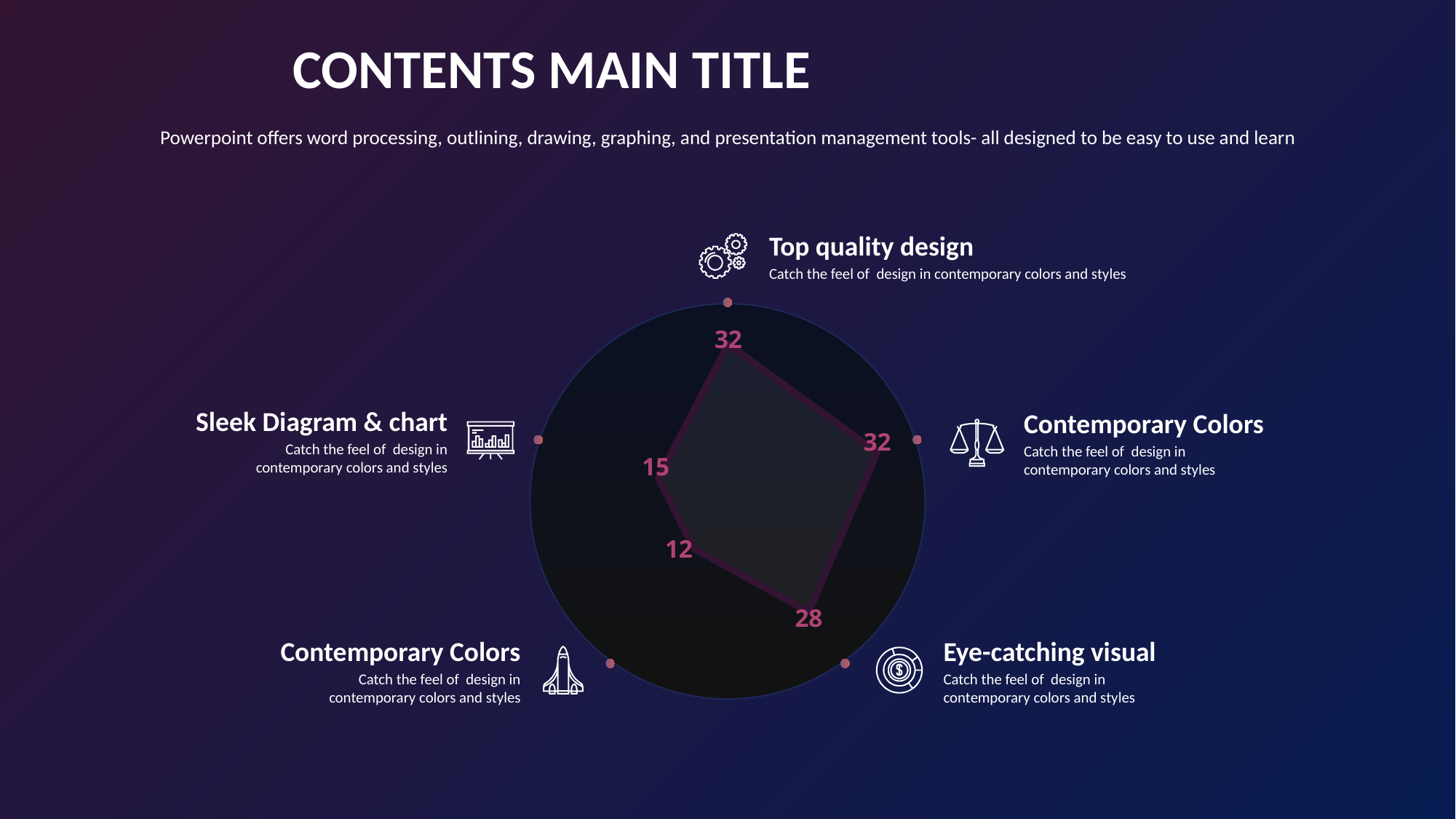
How many data points are plotted on the radar chart? 5 What is the difference between the value for "Eye-catching visual" (28) and the value for "Sleek Diagram & chart" (15)? 13 What kind of chart is shown on the slide? radar chart Which is larger on the radar chart: the value for "Sleek Diagram & chart" or the value for "Eye-catching visual"? Eye-catching visual What is the value plotted on the left side of the radar chart, next to "Sleek Diagram & chart"? 15 What is the value plotted at the bottom right of the radar chart, next to "Eye-catching visual"? 28 What is the lowest value plotted on the radar chart? 12 What is the highest value plotted on the radar chart? 32 What is the title of the slide containing the radar chart? CONTENTS MAIN TITLE What is the value plotted at the bottom left of the radar chart? 12 What is the difference between the top value (32) and the bottom-left value (12) on the radar chart? 20 What is the value plotted at the top of the radar chart, next to "Top quality design"? 32